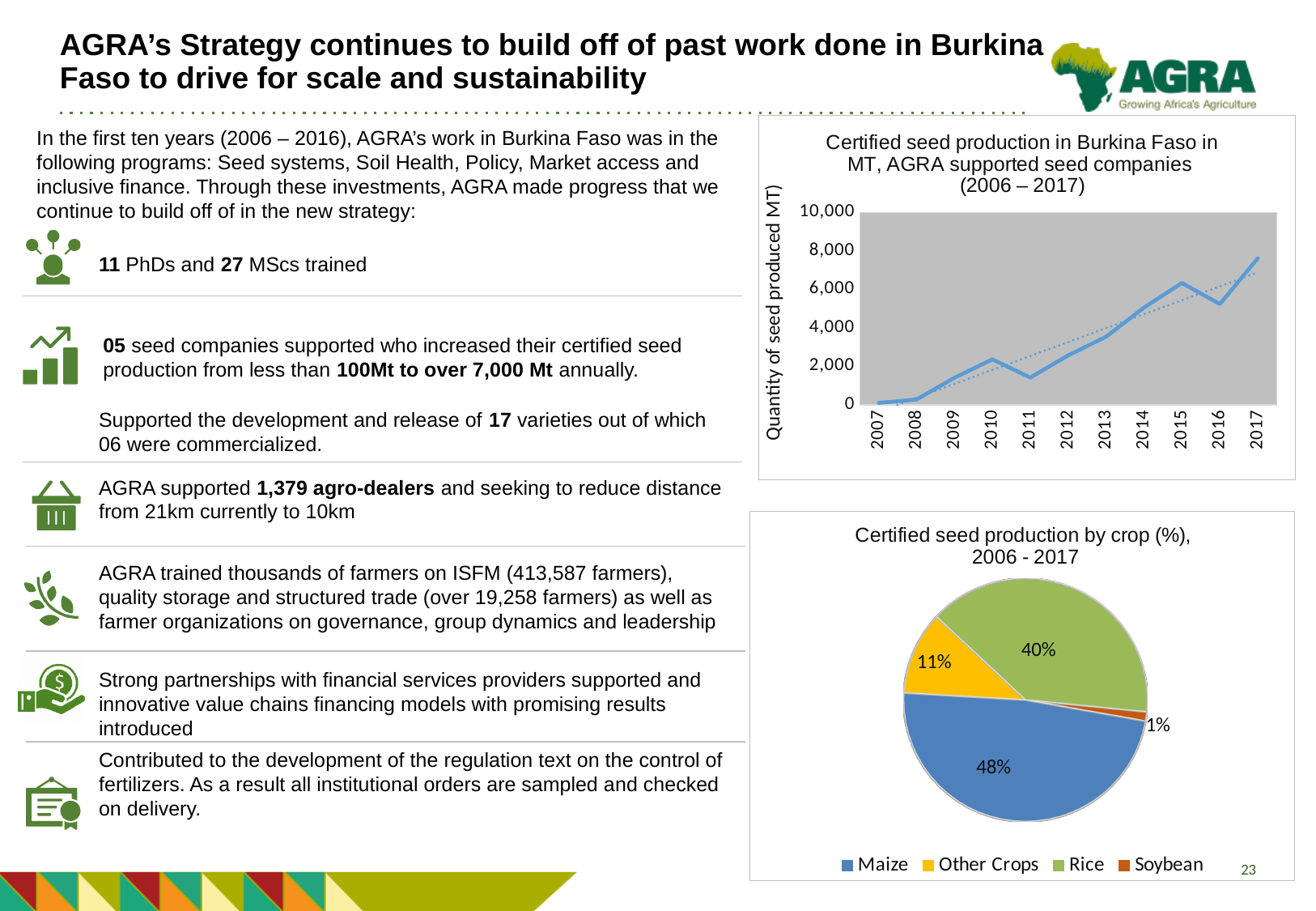
In the chart titled "Certified seed production in Burkina Faso in MT", how many years are shown on the x axis? 11 In the chart titled "Certified seed production in Burkina Faso in MT", is the value for 2017 greater or less than 6,000? greater In the chart titled "Certified seed production in Burkina Faso in MT", which year has the lowest quantity of seed produced? 2007 In the chart titled "Certified seed production by crop (%)", which crop has the smallest share? Soybean In the chart titled "Certified seed production by crop (%)", what share does Rice have? 40% In the chart titled "Certified seed production in Burkina Faso in MT", which year has the highest quantity of seed produced? 2017 In the chart titled "Certified seed production in Burkina Faso in MT", does the quantity of seed produced generally rise or fall from 2007 to 2017? rise In the chart titled "Certified seed production in Burkina Faso in MT", is the value for 2011 greater or less than 2,000? less In the chart titled "Certified seed production by crop (%)", how many crop categories does the legend list? 4 In the chart titled "Certified seed production by crop (%)", how many percentage points larger is the Maize share than the Rice share? 8 In the chart titled "Certified seed production in Burkina Faso in MT", what kind of chart is used? line chart In the chart titled "Certified seed production by crop (%)", what share does Maize have? 48%